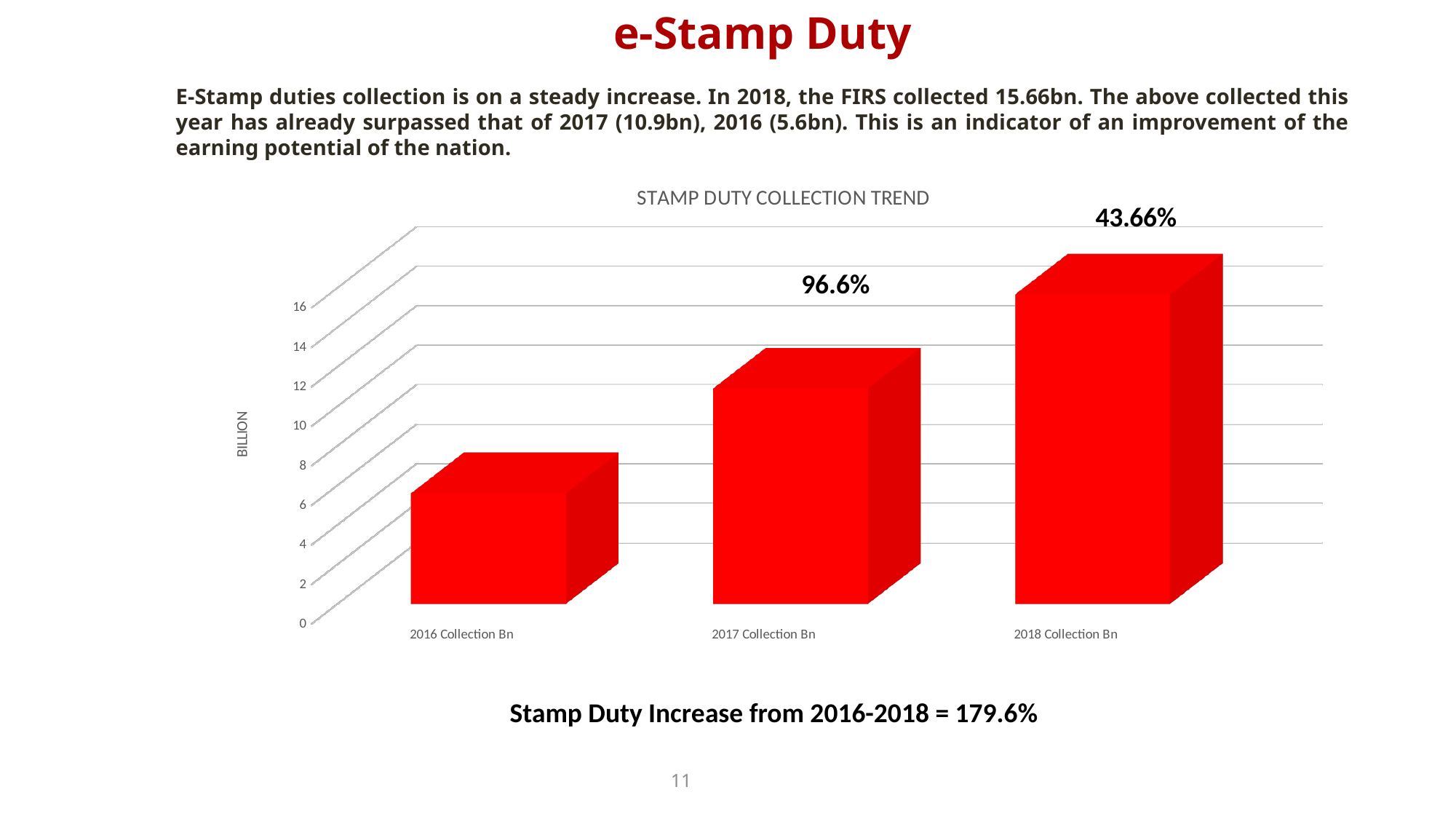
Is the value for 2016 Collection Bn greater or less than 8? less Do the bar values rise or fall from 2016 to 2018 along the x axis? rise What kind of chart is shown on the slide? bar chart What percentage label is printed above the 2018 Collection Bn bar? 43.66% How many categories (bars) does the chart show? 3 Is the value for 2018 Collection Bn greater or less than 12? greater What percentage label is printed above the 2017 Collection Bn bar? 96.6% Is the value for 2017 Collection Bn greater or less than 8? greater Which is larger, the bar for 2017 Collection Bn or the bar for 2016 Collection Bn? 2017 Collection Bn Which category has the lowest bar in the chart? 2016 Collection Bn Which category has the highest bar in the chart? 2018 Collection Bn What is the title of the chart? STAMP DUTY COLLECTION TREND